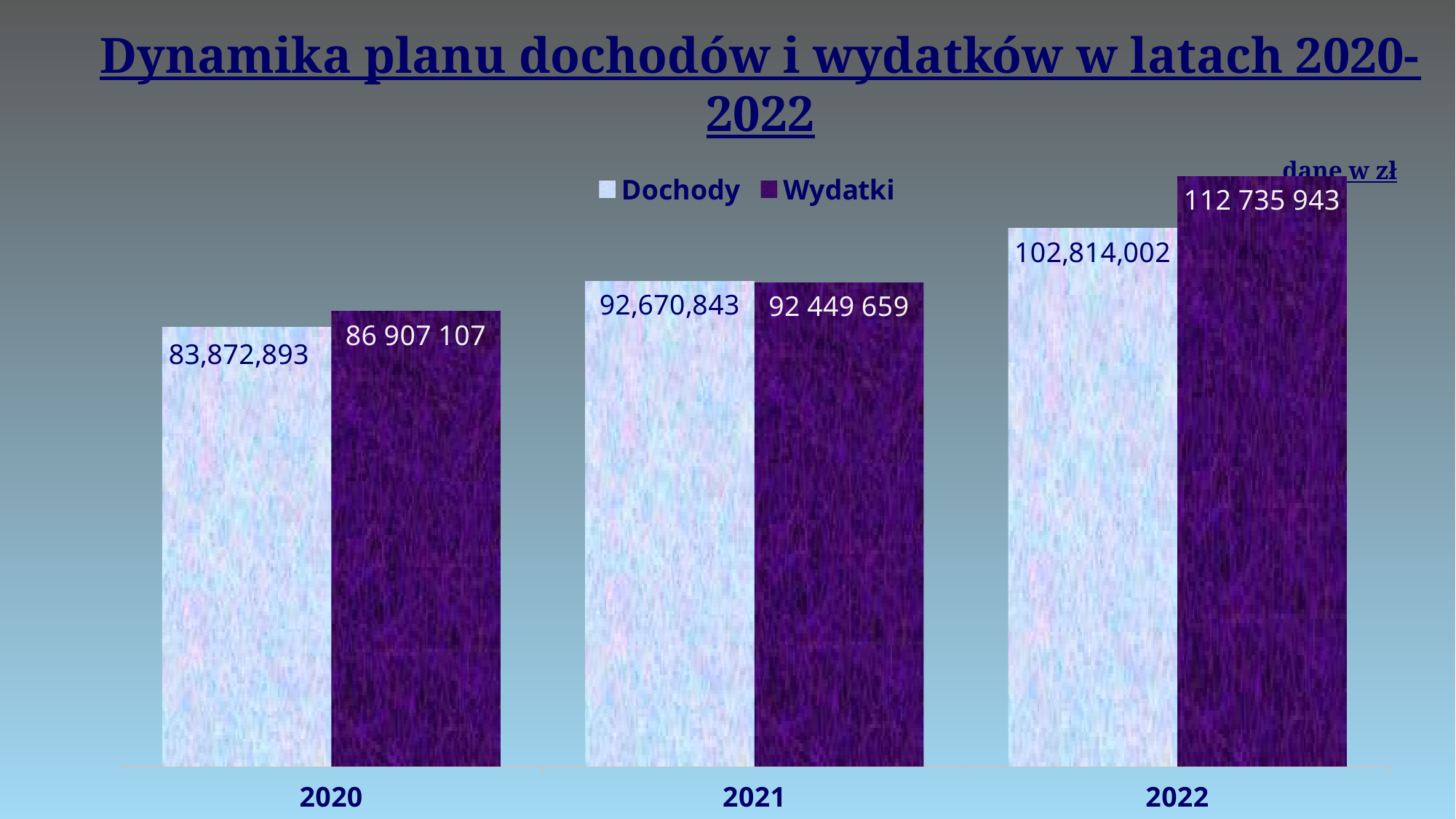
In which year is Wydatki highest? 2022 What is the difference between Dochody in 2022 and Dochody in 2020? 18,941,109 In 2020, which is larger, Dochody or Wydatki? Wydatki How many series does the legend list? 2 What is the difference between Wydatki and Dochody in 2022? 9,921,941 How many years are shown on the x axis? 3 What is the Wydatki value for 2022? 112 735 943 What is the Wydatki value for 2021? 92 449 659 In which year is Dochody lowest? 2020 Do the Dochody values rise or fall from 2020 to 2022? rise What is the Dochody value for 2020? 83,872,893 What is the Dochody value for 2022? 102,814,002